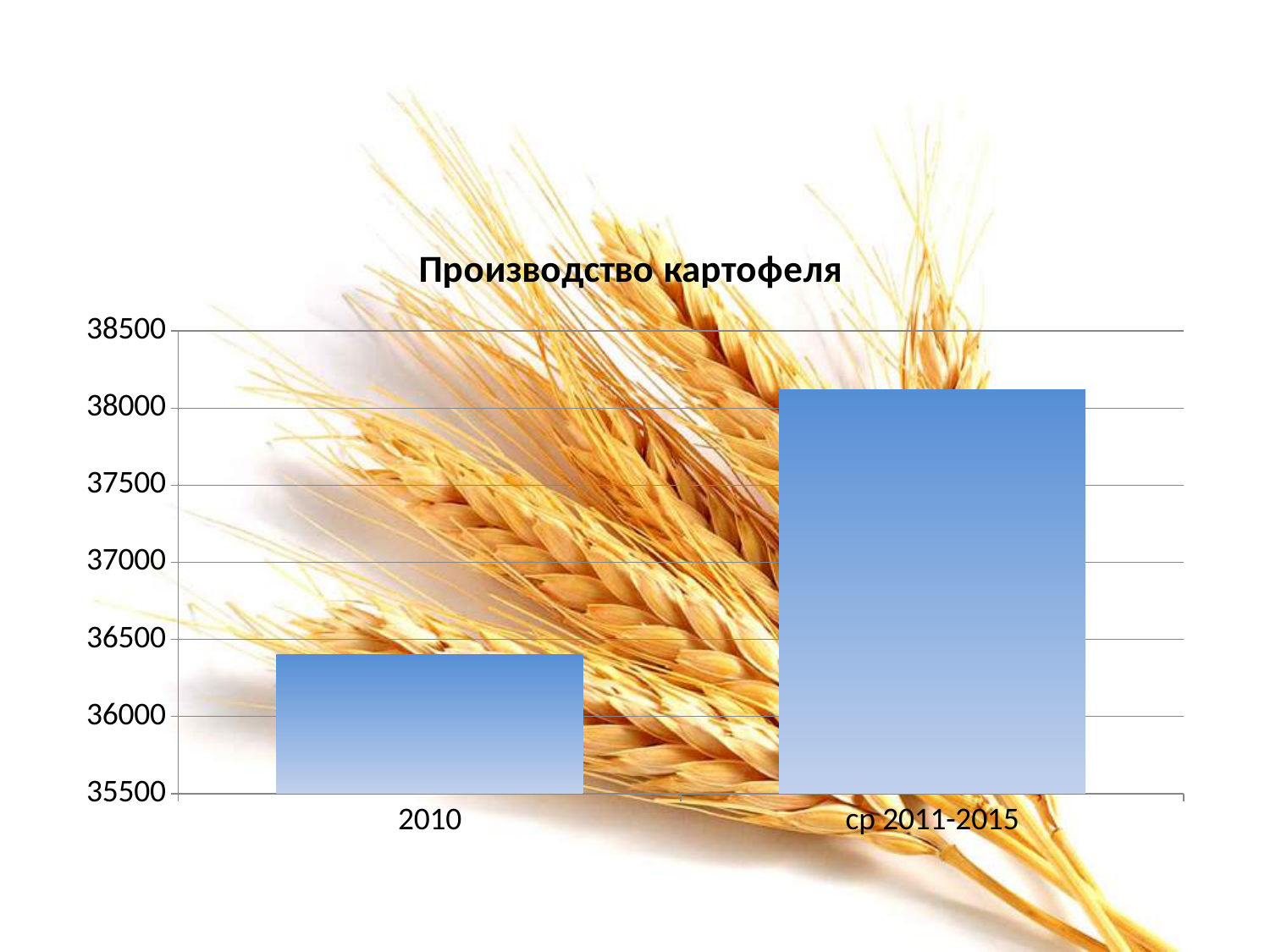
Is the value for 2010 greater or less than 37000? less Do the values rise or fall from 2010 to ср 2011-2015? rise What type of chart is shown on the slide? bar chart How many categories are plotted on the x axis? 2 Which category has the highest value? ср 2011-2015 Which is larger, the value for 2010 or the value for ср 2011-2015? ср 2011-2015 What is the title of the chart? Производство картофеля Is the value for 2010 greater or less than 36000? greater What is the lowest value shown on the vertical axis? 35500 Is the value for ср 2011-2015 greater or less than 37500? greater Which category has the lowest value? 2010